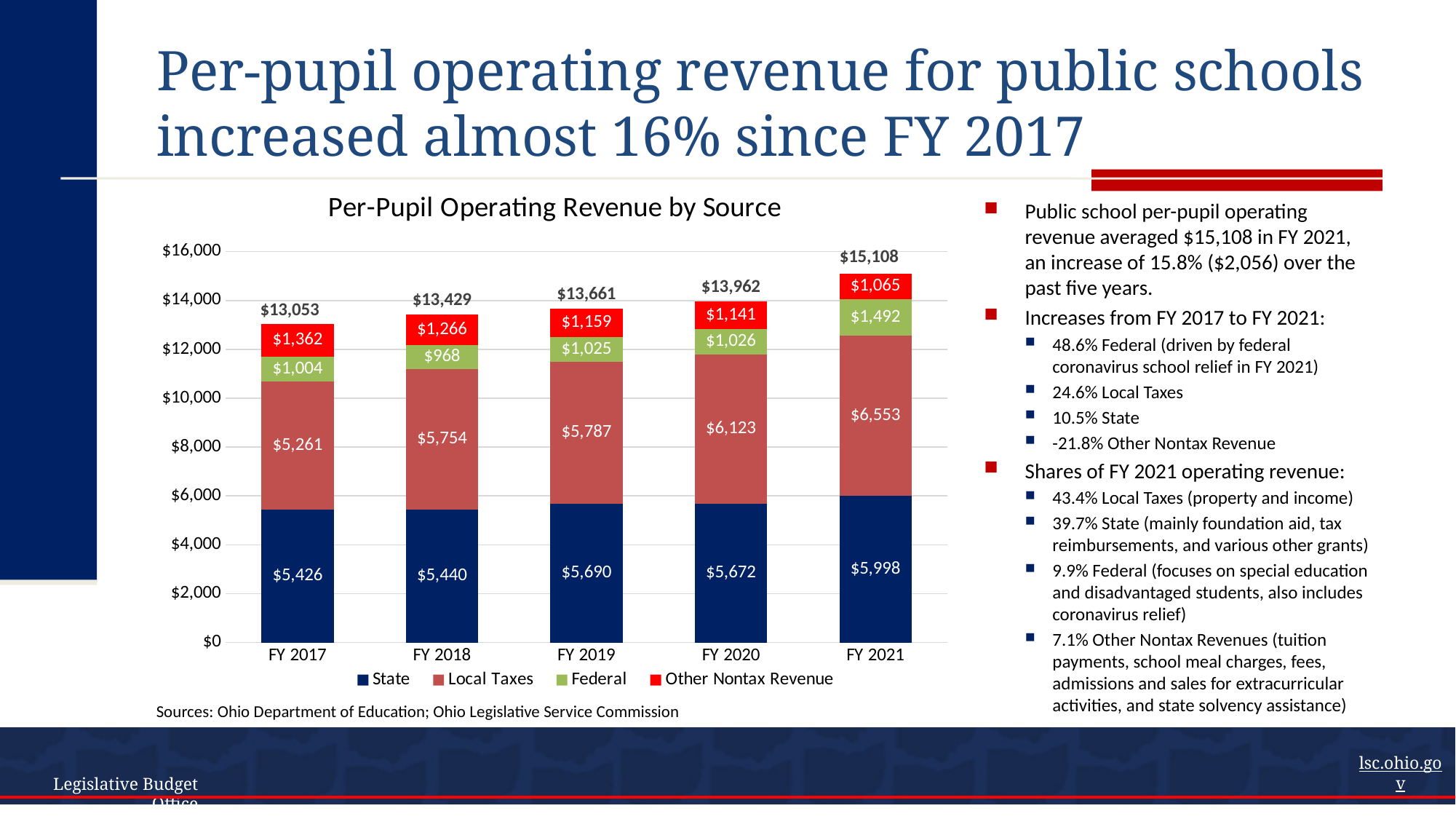
What is the difference between the Local Taxes values for FY 2021 and FY 2017? $1,292 What is the Local Taxes value for FY 2018? $5,754 Which fiscal year has the lowest Federal value? FY 2018 Does the total per-pupil operating revenue rise or fall from FY 2017 to FY 2021? rise How many fiscal years are shown on the x axis? 5 Which is larger, the State value for FY 2019 or for FY 2020? FY 2019 What is the total per-pupil operating revenue for FY 2020? $13,962 How many series does the legend list? 4 What is the Other Nontax Revenue value for FY 2017? $1,362 What is the Federal value for FY 2019? $1,025 What is the State per-pupil operating revenue for FY 2021? $5,998 Which fiscal year has the highest total per-pupil operating revenue? FY 2021